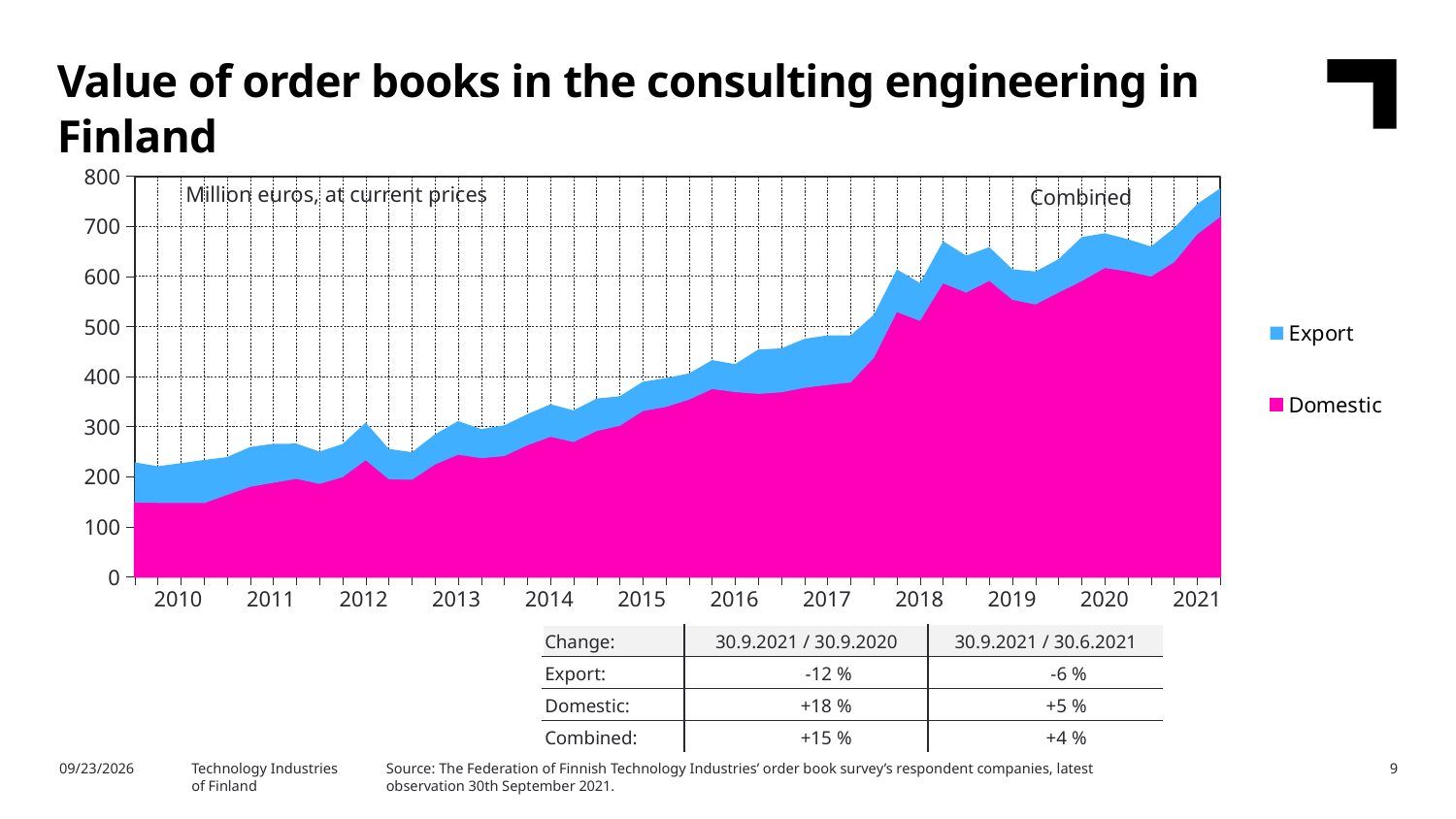
How many years are labelled on the x axis? 12 Is the combined value at the start of 2015 greater or less than 400? less Is the Domestic value at the start of 2010 greater or less than 200? less Does the combined value of order books generally rise or fall from 2010 to 2021? Rise What kind of chart is shown on the slide? Stacked area chart What unit is stated for the values in the chart? Million euros, at current prices In 2021, which is larger, the Domestic or the Export portion of the order books? Domestic Is the Domestic value at the end of 2021 greater or less than 600? greater Which two series are listed in the legend? Export and Domestic How many series does the legend list? 2